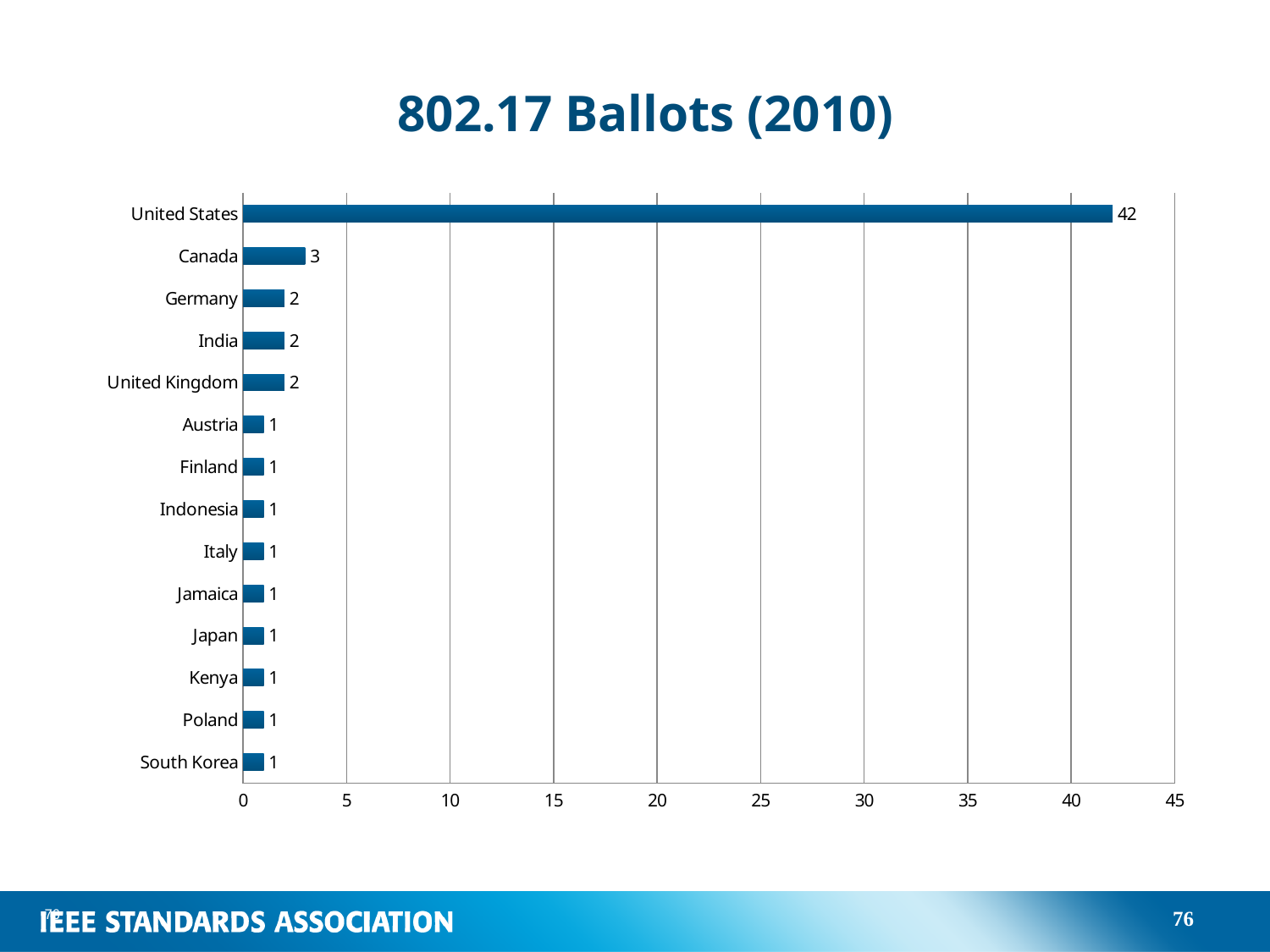
What is the value for United States? 42 What kind of chart is shown on the slide? bar chart What is the value for Germany? 2 Which category has the highest value? United States What is the difference between the values for United States and Canada? 39 Is the value for United States greater or less than 40? greater How many categories are shown in the chart? 14 What is the difference between the values for Canada and India? 1 Which is larger, the value for Canada or the value for United Kingdom? Canada What is the title of the chart? 802.17 Ballots (2010) What is the value for Japan? 1 What is the value for Canada? 3